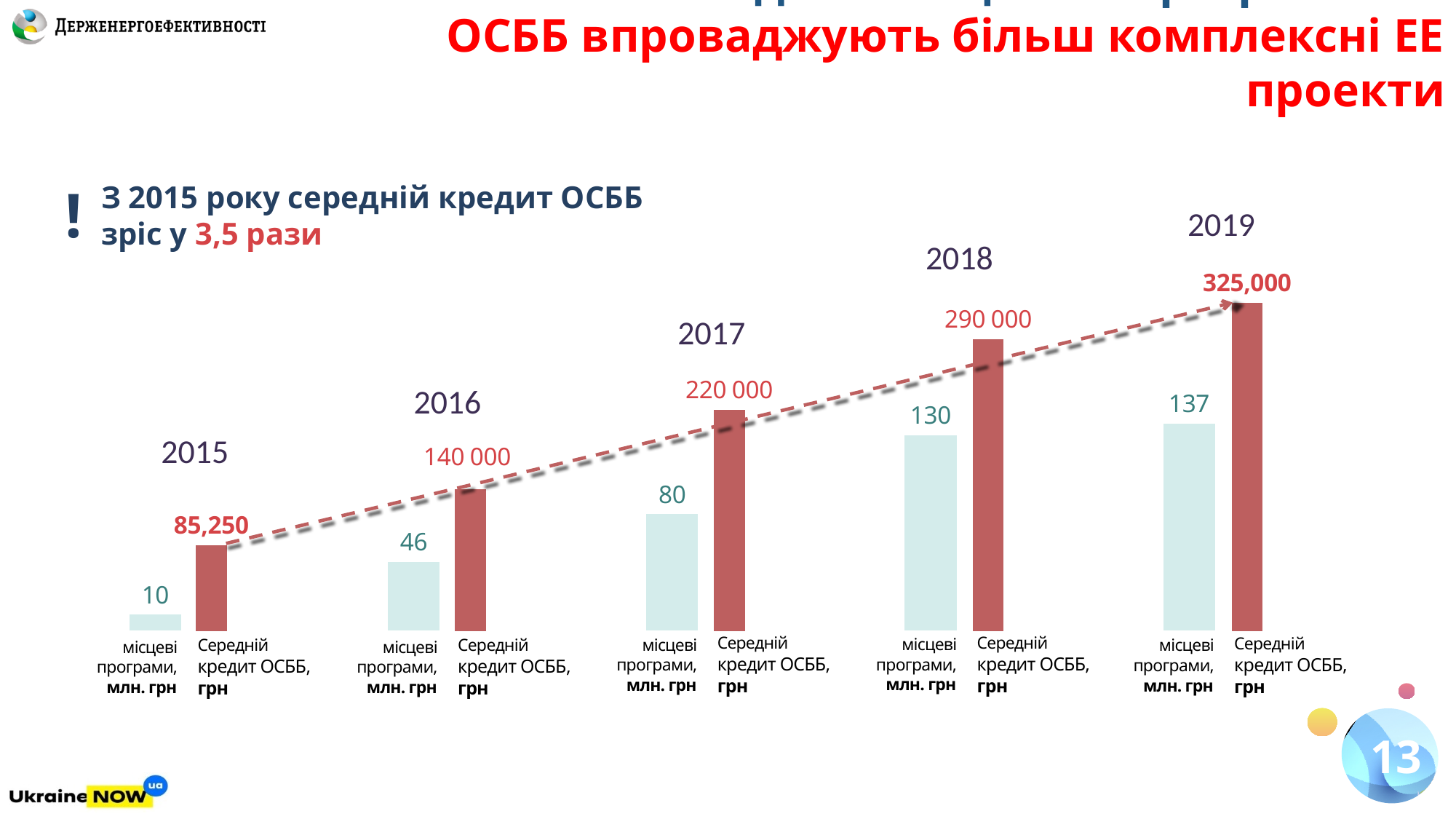
Do the average OSBB loan values rise or fall from 2015 to 2019? rise What is the value of the local programs (місцеві програми, млн. грн) bar for 2018? 130 What is the value of the local programs (місцеві програми, млн. грн) bar for 2015? 10 Which is larger: the local programs value for 2016 or for 2017? 2017 What is the average OSBB loan (Середній кредит ОСББ, грн) shown for 2019? 325,000 What is the difference between the local programs values for 2019 and 2018? 7 What is the difference between the average OSBB loan in 2018 and in 2017? 70 000 What kind of chart is shown on the slide? bar chart Which year has the lowest average OSBB loan (Середній кредит ОСББ, грн)? 2015 What is the average OSBB loan (Середній кредит ОСББ, грн) shown for 2017? 220 000 Which year has the highest value for local programs (місцеві програми, млн. грн)? 2019 How many years are shown on the chart? 5